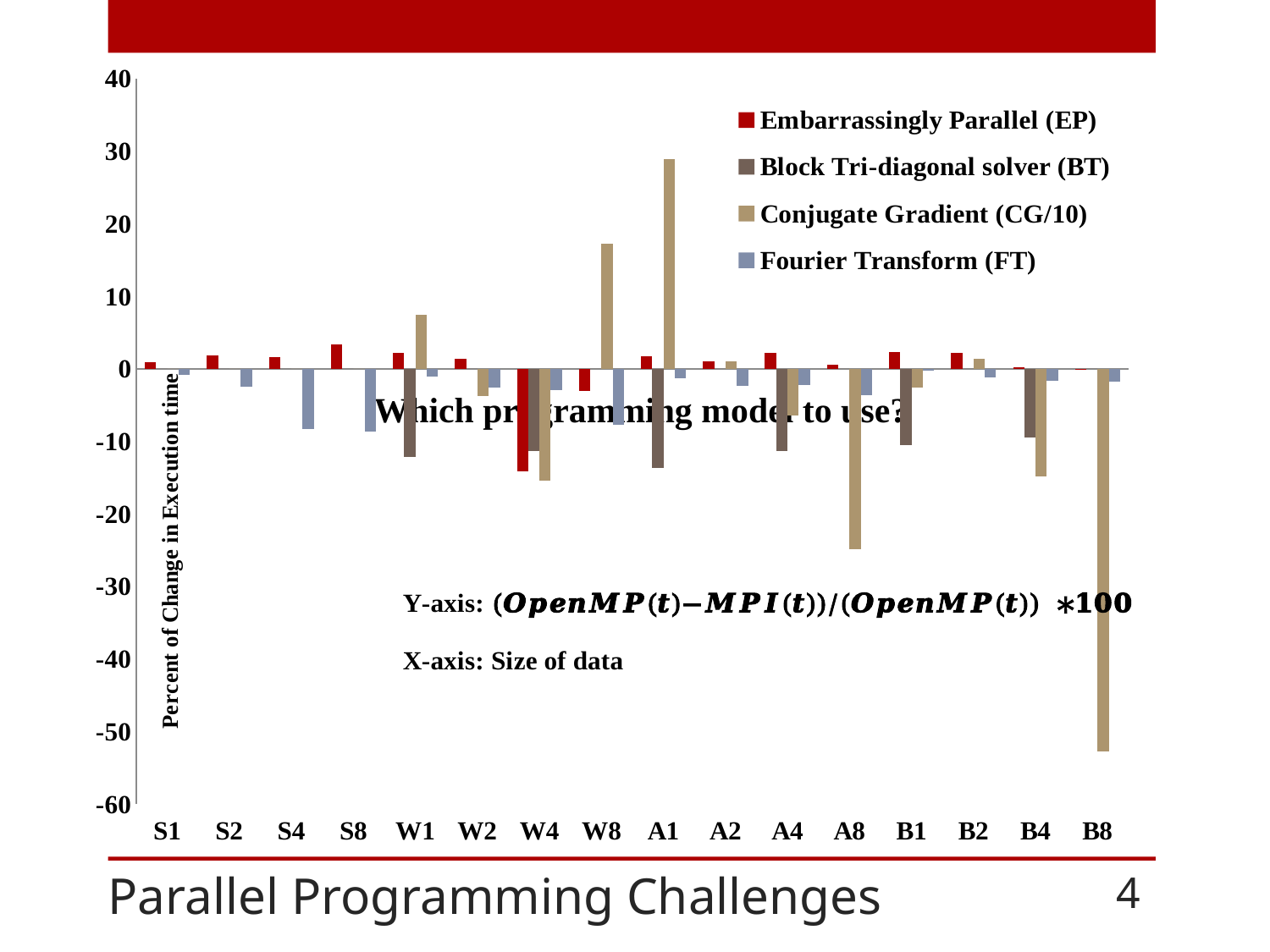
Which is larger, the Conjugate Gradient (CG/10) value for A1 or for W8? A1 What is the label of the y axis? Percent of Change in Execution time What kind of chart is shown on the slide? bar chart Is the Conjugate Gradient (CG/10) value for A8 greater or less than -20? less Which category has the lowest bar in the chart? B8 Is the Embarrassingly Parallel (EP) value for W4 greater or less than -10? less Is the Conjugate Gradient (CG/10) value for B8 greater or less than -40? less Which category has the highest bar in the chart? A1 Which series has the lowest value in the chart? Conjugate Gradient (CG/10) How many categories are shown on the x axis? 16 How many series does the legend list? 4